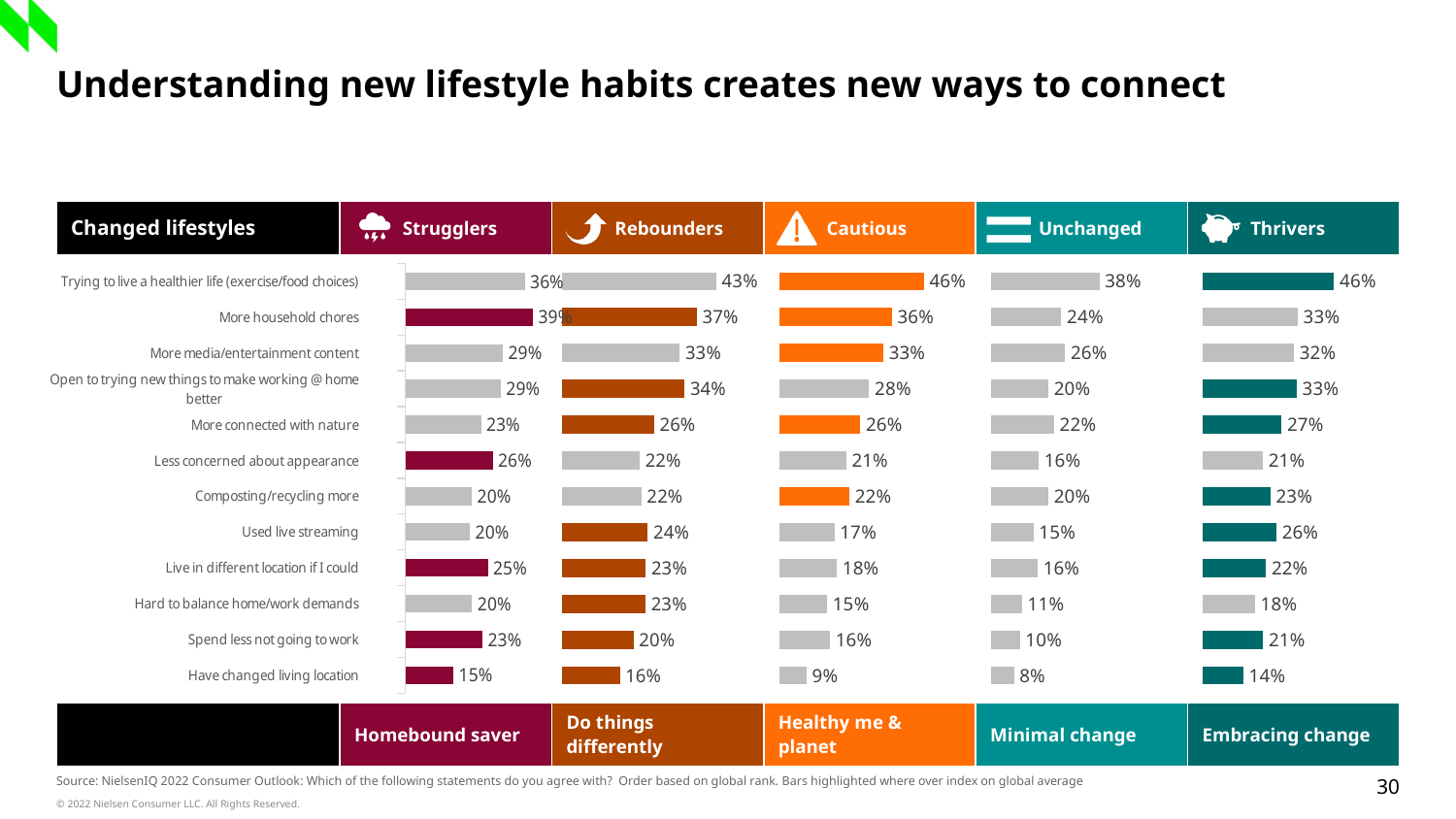
In the Rebounders chart, what is the difference between "Trying to live a healthier life (exercise/food choices)" and "More household chores"? 6% What type of chart is used for each consumer segment on this slide? Bar chart In the Unchanged chart, what is the difference between "More media/entertainment content" and "Hard to balance home/work demands"? 15% In the Strugglers chart, what is the value for "More household chores"? 39% How many categories (lifestyle statements) are plotted in each chart? 12 In the Rebounders chart, which category has the highest value? Trying to live a healthier life (exercise/food choices) Which is larger for "Open to trying new things to make working @ home better": the Rebounders value or the Cautious value? Rebounders In the Cautious chart, what is the value for "Trying to live a healthier life (exercise/food choices)"? 46% In the Unchanged chart, what is the value for "Have changed living location"? 8% In the Thrivers chart, what is the value for "Used live streaming"? 26% What label appears beneath the Thrivers chart? Embracing change In the Cautious chart, which category has the lowest value? Have changed living location